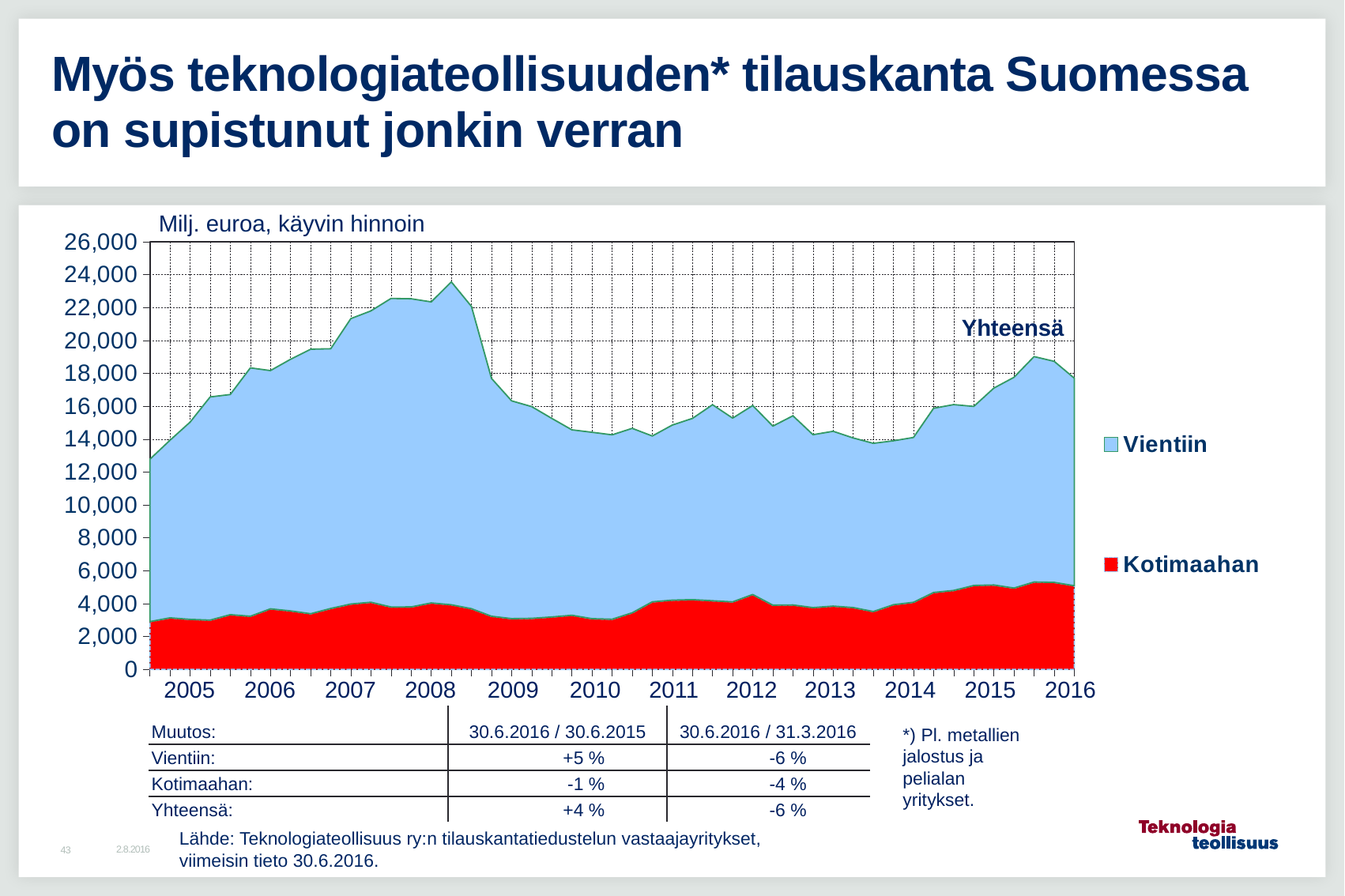
What unit label is shown above the chart? Milj. euroa, käyvin hinnoin Is the total (Yhteensä) value at the start of 2005 greater or less than 14,000? less Which is larger, the total order book in 2008 or in 2016? 2008 What kind of chart is shown on the slide? Stacked area chart Is the total (Yhteensä) value in 2013 greater or less than 16,000? less How many series does the chart legend list? 2 Is the Kotimaahan value in 2016 greater or less than 4,000? greater Which two series are listed in the chart legend? Vientiin and Kotimaahan In which year does the total (Yhteensä) order book reach its highest level? 2008 Does the total (Yhteensä) order book rise or fall between 2005 and 2008? rise How many years are labelled on the x axis? 12